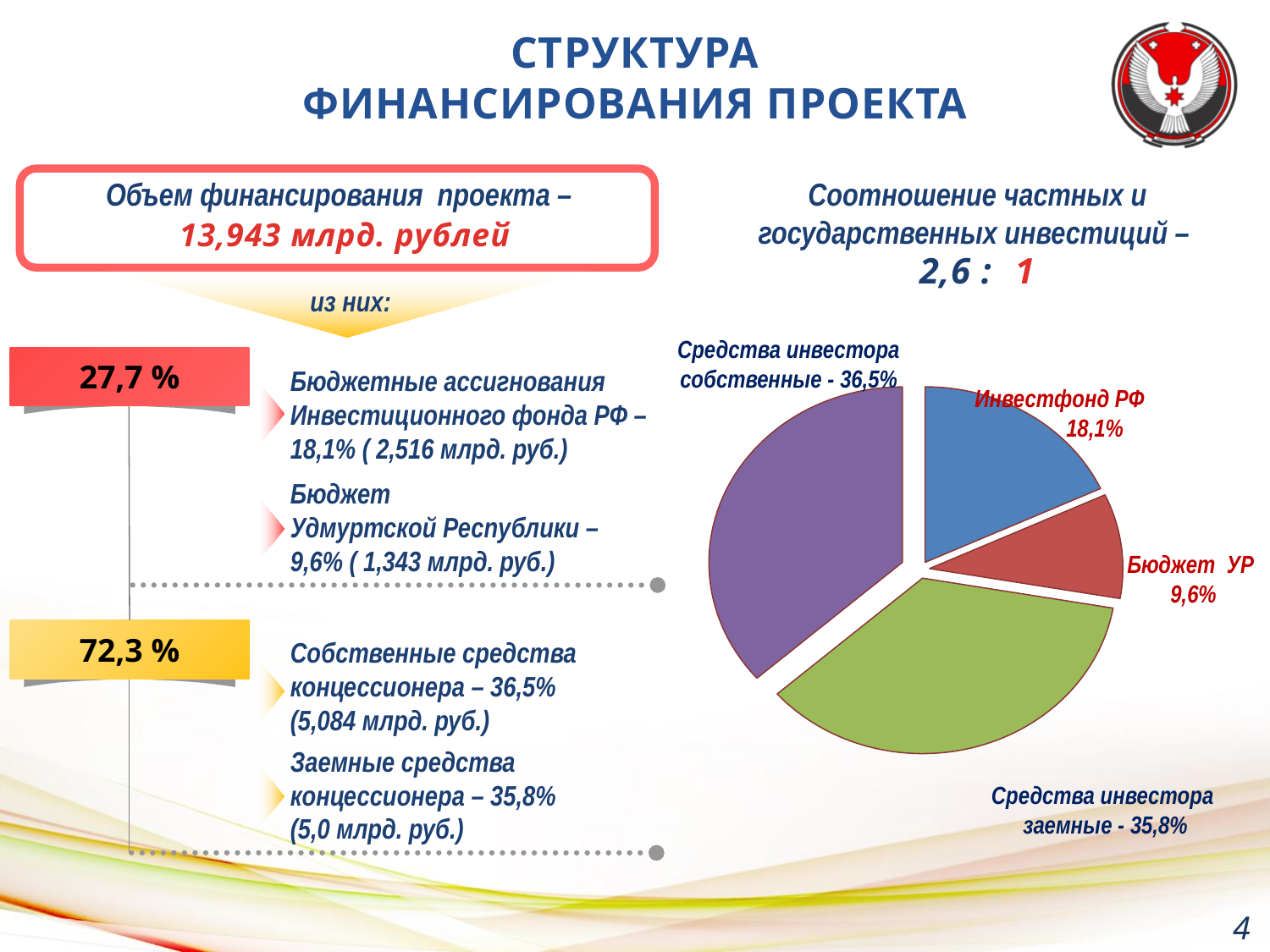
What kind of chart is shown on the slide? pie chart Which slice of the pie chart is the largest? Средства инвестора собственные What share of the pie does Бюджет УР represent? 9,6% What share of the pie does Средства инвестора заемные represent? 35,8% What is the difference in percentage points between Инвестфонд РФ and Бюджет УР in the pie chart? 8,5 What share of the pie does Средства инвестора собственные represent? 36,5% How many slices does the pie chart have? 4 What is the combined share of the two Средства инвестора slices (собственные and заемные)? 72,3% What share of the pie does Инвестфонд РФ represent? 18,1% Which slice of the pie chart is the smallest? Бюджет УР Which is larger in the pie chart: Инвестфонд РФ or Бюджет УР? Инвестфонд РФ What colour is the Бюджет УР slice in the pie chart? red